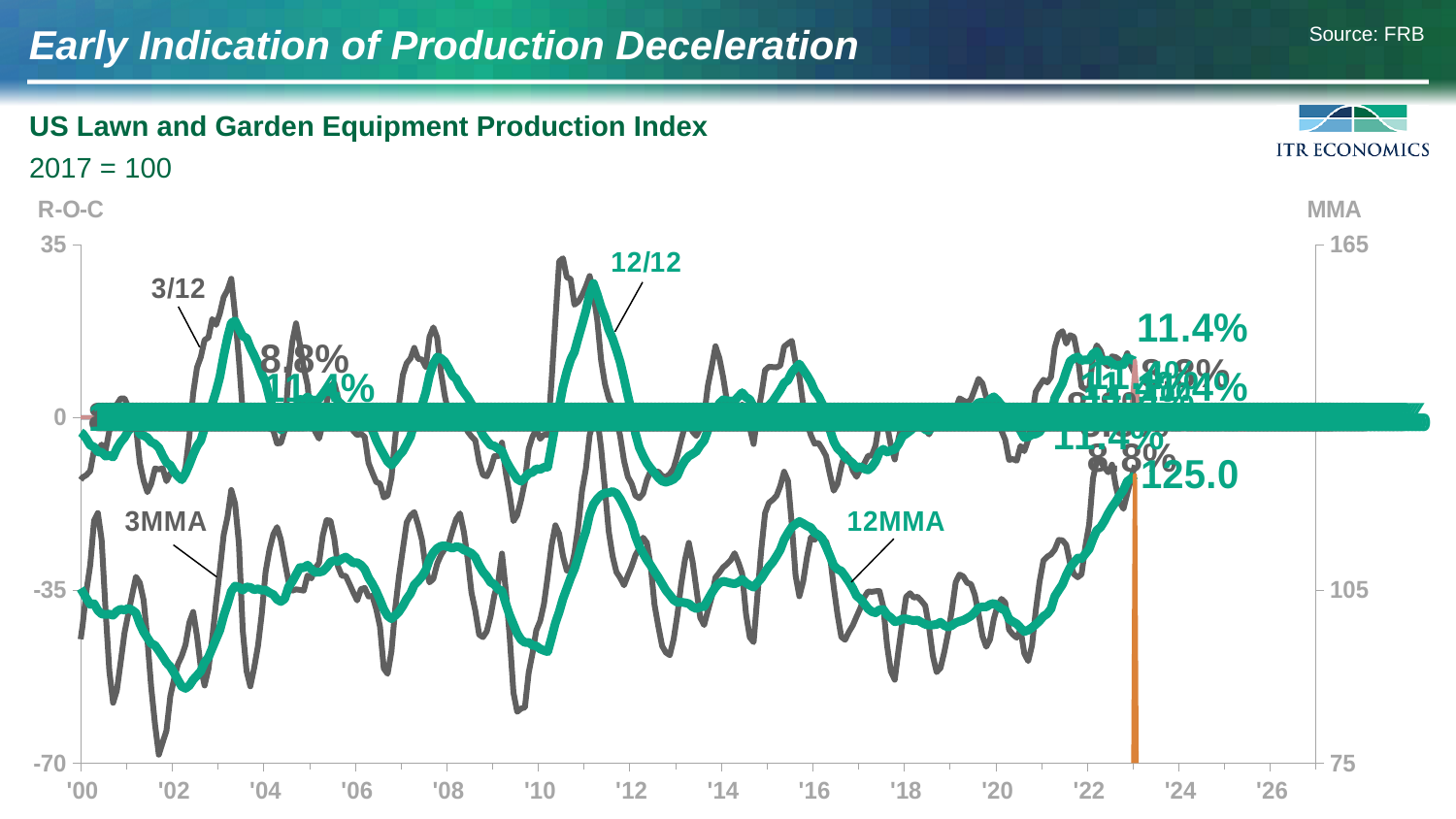
What is the latest labeled value of the 12MMA line? 125.0 What kind of chart is shown on the slide? Line chart What is the title of the chart? US Lawn and Garden Equipment Production Index What is the lowest value shown on the left-hand R-O-C axis? -70 How many labeled series (lines) are plotted on the chart? 4 What is the highest value shown on the right-hand MMA axis? 165 Does the 12MMA line rise or fall between '20 and '23? rise How many year labels are shown along the x axis? 14 Is the 12MMA value around '10 greater or less than 105? less What is the latest labeled 12/12 rate-of-change value shown at the top right of the chart? 11.4% What is the source cited for the chart data? FRB What base year is the index set to 100? 2017